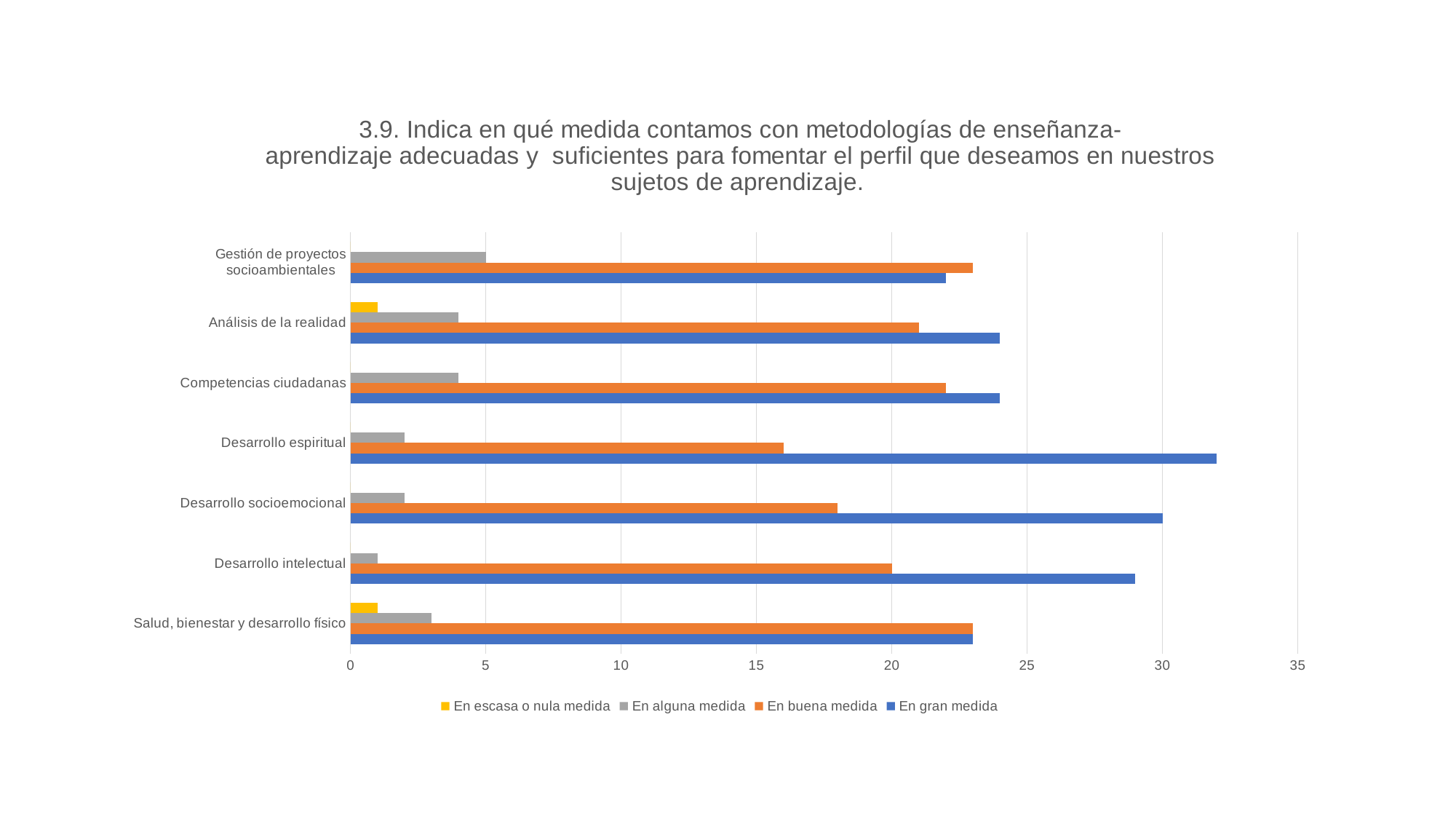
Which is larger: "En buena medida" for Análisis de la realidad or "En buena medida" for Desarrollo espiritual? Análisis de la realidad How many series does the legend list? 4 Which category has the highest value for "En alguna medida"? Gestión de proyectos socioambientales Is the value of "En gran medida" for Desarrollo espiritual greater or less than 30? greater What is the value of "En alguna medida" for Gestión de proyectos socioambientales? 5 Which category has the lowest value for "En buena medida"? Desarrollo espiritual What is the value of "En buena medida" for Desarrollo intelectual? 20 How many categories are shown on the chart? 7 Is the value of "En buena medida" for Análisis de la realidad greater or less than 25? less What kind of chart is shown on the slide? Bar chart What is the value of "En gran medida" for Desarrollo socioemocional? 30 Which category has the highest value for "En gran medida"? Desarrollo espiritual